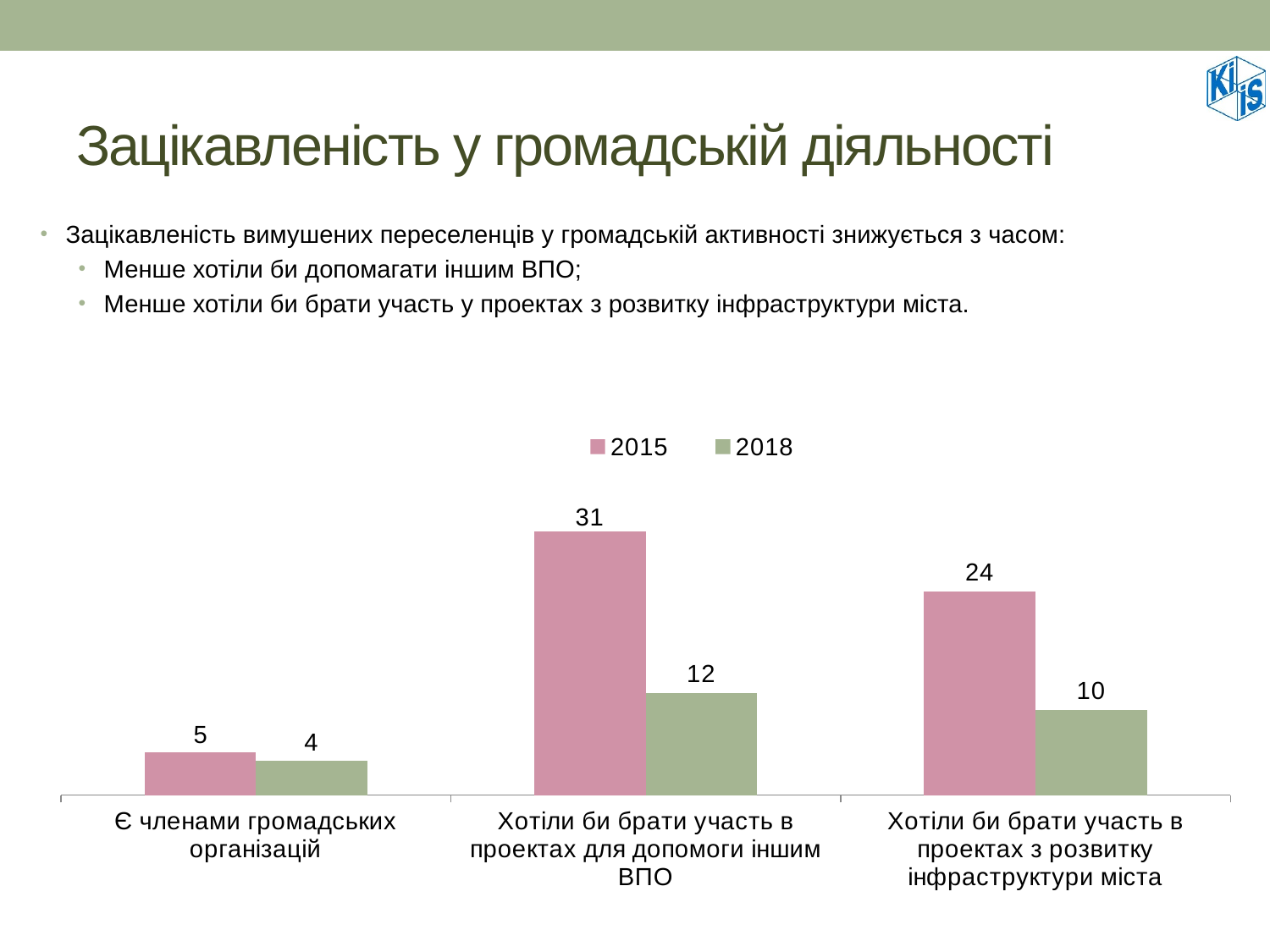
How many series does the legend list? 2 How many categories are shown on the x axis? 3 What is the difference between the 2015 and 2018 values for "Хотіли би брати участь в проектах з розвитку інфраструктури міста"? 14 What is the difference between the 2015 and 2018 values for "Хотіли би брати участь в проектах для допомоги іншим ВПО"? 19 What is the 2018 value for "Є членами громадських організацій"? 4 What is the 2018 value for "Хотіли би брати участь в проектах з розвитку інфраструктури міста"? 10 Which category has the highest 2015 value? Хотіли би брати участь в проектах для допомоги іншим ВПО Which category has the lowest 2018 value? Є членами громадських організацій Which is larger: the 2015 value for "Є членами громадських організацій" or the 2018 value for the same category? 2015 What is the 2015 value for "Хотіли би брати участь в проектах для допомоги іншим ВПО"? 31 What kind of chart is shown on the slide? Bar chart Which series is shown in pink? 2015